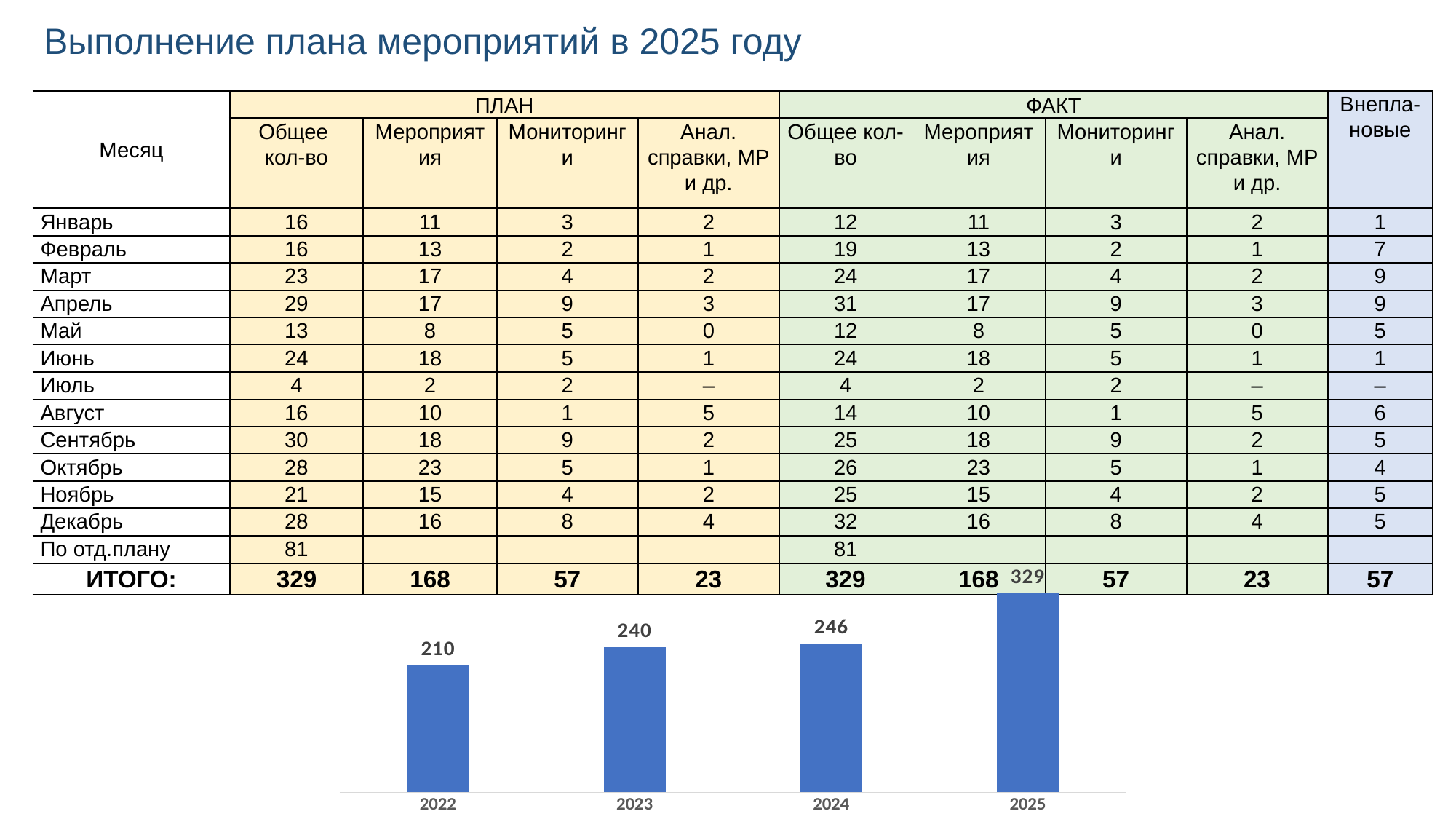
How many bars are in the bar chart at the bottom of the slide? 4 In the bar chart at the bottom of the slide, what is the value for 2025? 329 In the bar chart at the bottom of the slide, what is the value for 2022? 210 In the bar chart at the bottom of the slide, what is the difference between the values for 2023 and 2022? 30 In the bar chart at the bottom of the slide, do the values rise or fall from 2022 to 2025? rise In the bar chart at the bottom of the slide, what is the value for 2023? 240 In the bar chart at the bottom of the slide, what is the value for 2024? 246 In the bar chart at the bottom of the slide, which year has the lowest value? 2022 What type of chart is shown at the bottom of the slide? bar chart In the bar chart at the bottom of the slide, which is larger, the value for 2022 or the value for 2023? 2023 In the bar chart at the bottom of the slide, which year has the highest value? 2025 In the bar chart at the bottom of the slide, what is the difference between the values for 2025 and 2024? 83